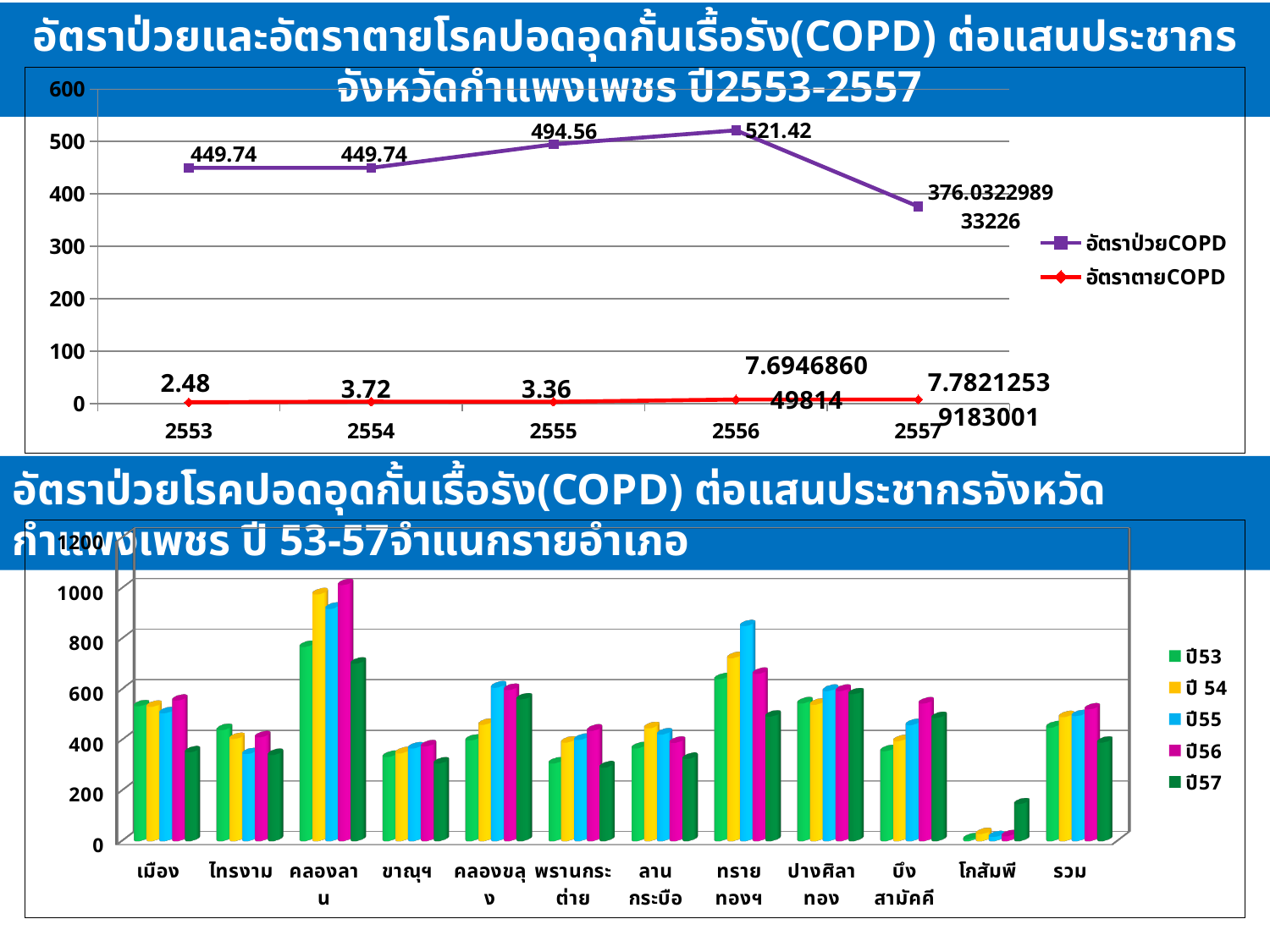
How many categories are shown on the x axis of the bottom chart? 12 In the top chart, what is the value of อัตราป่วยCOPD in 2555? 494.56 How many series does the legend of the bottom chart list? 5 How many series does the legend of the top chart list? 2 What kind of chart is the top chart? line chart In the top chart, which year has the lowest อัตราป่วยCOPD? 2557 In the top chart, which year has the larger อัตราตายCOPD value, 2554 or 2555? 2554 In the top chart, what is the value of อัตราตายCOPD in 2553? 2.48 In the bottom chart, is the value for ทรายทองฯ in ปี55 greater or less than 800? greater What kind of chart is the bottom chart? bar chart In the top chart, which year has the highest อัตราป่วยCOPD? 2556 In the top chart, what is the difference between the อัตราป่วยCOPD values for 2556 and 2555? 26.86